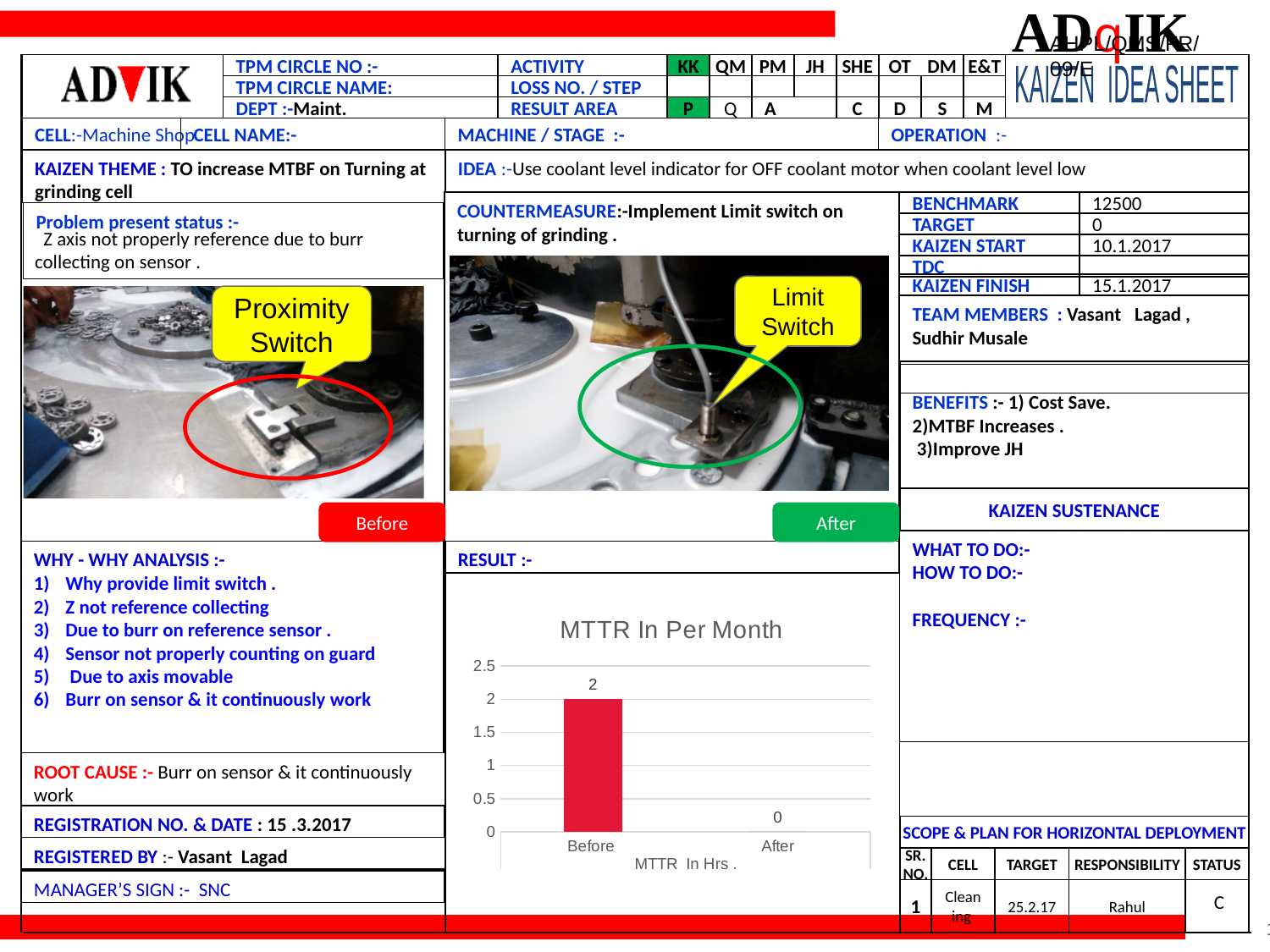
Is the value for Before greater or less than 1.5? greater What is the MTTR value for Before? 2 Do the values rise or fall from Before to After in the MTTR chart? fall Which category has the lowest value in the MTTR In Per Month chart? After Which category has the highest value in the MTTR In Per Month chart? Before How many categories are shown on the x axis of the MTTR chart? 2 Which is larger in the MTTR chart, the Before value or the After value? Before What kind of chart is shown under RESULT? bar chart What is the difference between the Before and After values in the MTTR chart? 2 What is the MTTR value for After? 0 What is the title of the chart on the slide? MTTR In Per Month